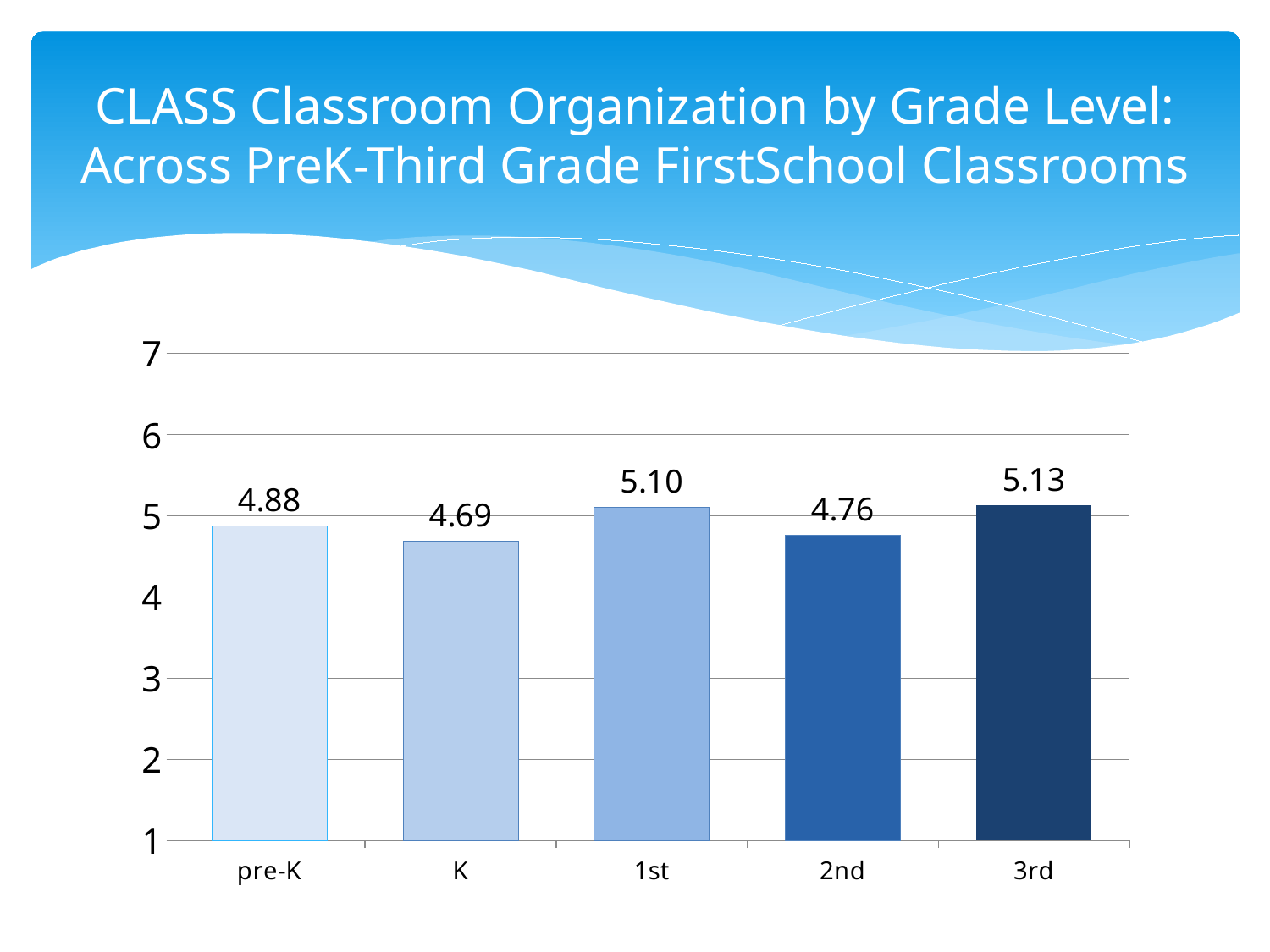
What is the value for pre-K? 4.88 What kind of chart is shown on the slide? bar chart Which grade level has the lowest value? K What is the value for K? 4.69 Is the value for 1st greater or less than 5? greater What is the value for 1st? 5.10 What is the value for 2nd? 4.76 How many grade levels are shown on the chart? 5 Which is larger, the value for pre-K or the value for 2nd? pre-K Which grade level has the highest value? 3rd What is the difference between the values for 3rd and K? 0.44 What is the value for 3rd? 5.13